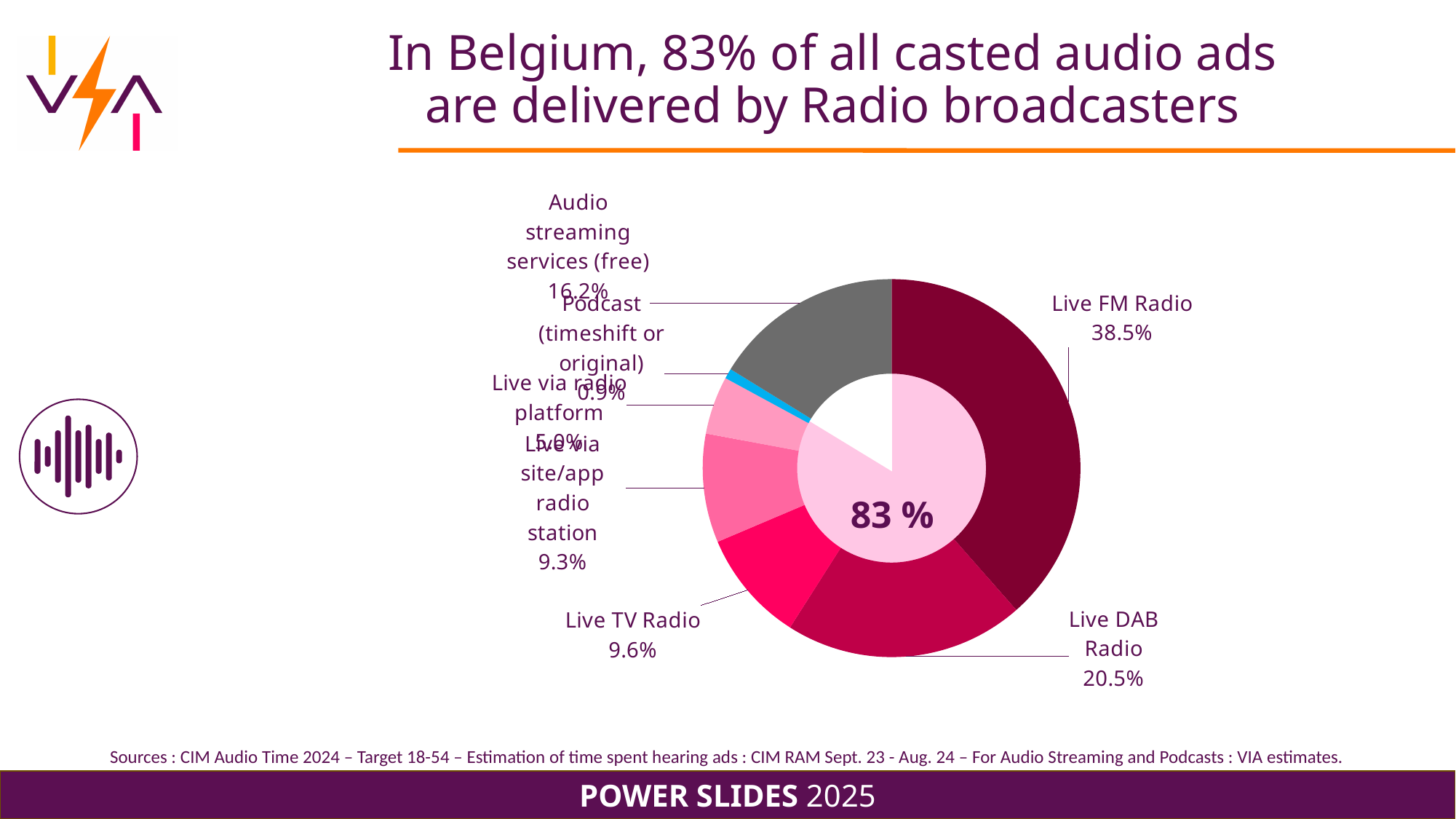
Which is larger: the share for Live DAB Radio or the share for Audio streaming services (free)? Live DAB Radio What percentage is printed in the centre of the donut chart? 83 % What share of casted audio ads is delivered by Audio streaming services (free)? 16.2% What share of casted audio ads is delivered by Live TV Radio? 9.6% Which category has the smallest slice of the pie? Podcast (timeshift or original) What share of casted audio ads is delivered by Live DAB Radio? 20.5% What share of casted audio ads is delivered by Live via site/app radio station? 9.3% How many categories are shown in the pie chart? 7 Which category has the largest slice of the pie? Live FM Radio What share of casted audio ads is delivered by Live FM Radio? 38.5% What type of chart is shown on the slide? doughnut (donut) chart What is the difference in percentage points between Live FM Radio and Live DAB Radio? 18.0%